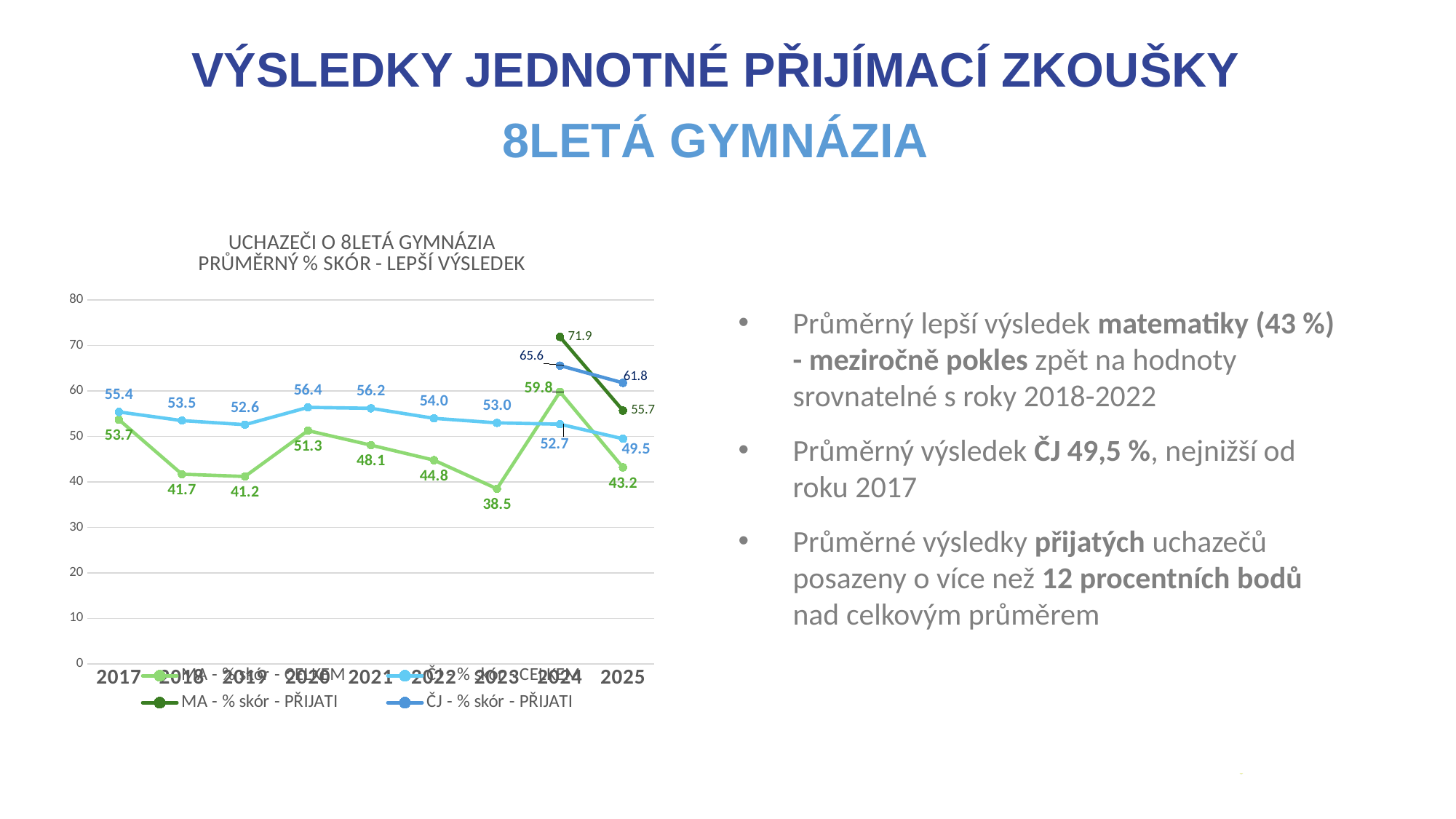
In which year is the MA - % skór - CELKEM series at its highest? 2024 How many series does the chart legend list? 4 What is the title of the chart? UCHAZEČI O 8LETÁ GYMNÁZIA PRŮMĚRNÝ % SKÓR - LEPŠÍ VÝSLEDEK What is the difference between the MA - % skór - PŘIJATI value in 2024 and in 2025? 16.2 How many years are shown on the x axis of the chart? 9 In which year is the ČJ - % skór - CELKEM series at its lowest? 2025 What is the value of the ČJ - % skór - PŘIJATI series in 2025? 61.8 What is the value of the MA - % skór - PŘIJATI series in 2024? 71.9 What kind of chart is shown on the slide? line chart What is the value of the ČJ - % skór - CELKEM series in 2020? 56.4 What is the value of the MA - % skór - CELKEM series in 2023? 38.5 Which is larger in 2025: the ČJ - % skór - PŘIJATI value or the MA - % skór - PŘIJATI value? ČJ - % skór - PŘIJATI